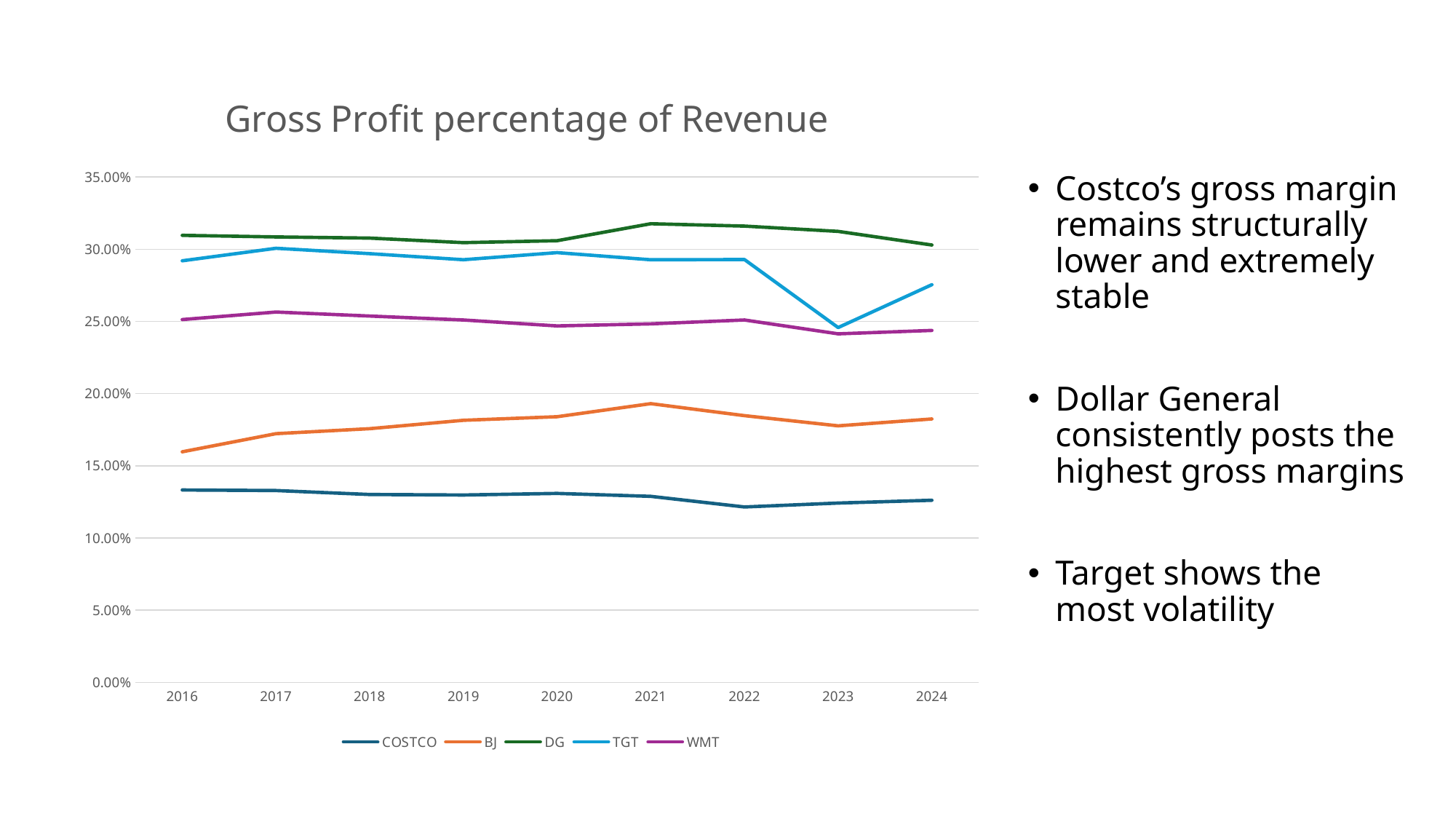
Which is larger in 2023, the value for DG or the value for TGT? DG Which series has the lowest gross profit percentage in 2024? COSTCO Which is larger in 2020, the value for WMT or the value for BJ? WMT Is the value for BJ in 2016 greater or less than 15.00%? greater What is the title of the chart? Gross Profit percentage of Revenue What kind of chart is shown on the slide? line chart Is the value for TGT in 2024 greater or less than 25.00%? greater How many years are plotted along the x axis? 9 Does the TGT line rise or fall from 2022 to 2023? fall Which series has the highest gross profit percentage in 2021? DG How many series does the legend list? 5 Is the value for COSTCO in 2022 greater or less than 15.00%? less